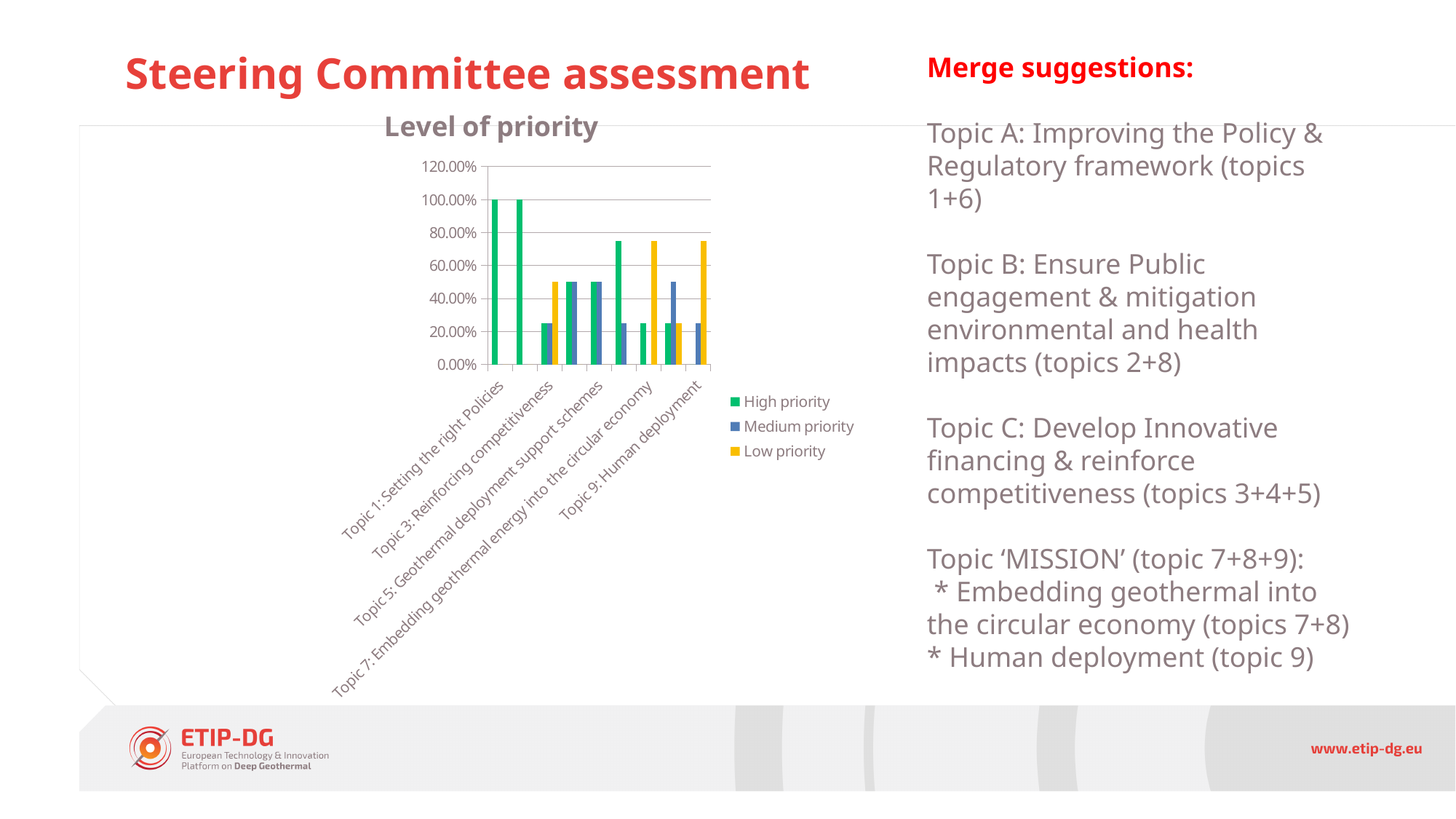
Is the High priority value for Topic 3: Reinforcing competitiveness greater or less than 40.00%? less Does the High priority series generally rise or fall from Topic 1 to Topic 9? fall What is the High priority value for Topic 1: Setting the right Policies? 100.00% Which has the larger High priority value, Topic 1: Setting the right Policies or Topic 3: Reinforcing competitiveness? Topic 1: Setting the right Policies Is the Low priority value for Topic 3: Reinforcing competitiveness greater or less than 40.00%? greater Which has the larger Low priority value, Topic 3: Reinforcing competitiveness or Topic 7: Embedding geothermal energy into the circular economy? Topic 7: Embedding geothermal energy into the circular economy What kind of chart is shown under the title 'Level of priority'? Bar chart Is the Medium priority value for Topic 9: Human deployment greater or less than 40.00%? less How many series does the legend of the 'Level of priority' chart list? 3 Which colour represents the High priority series in the chart legend? Green